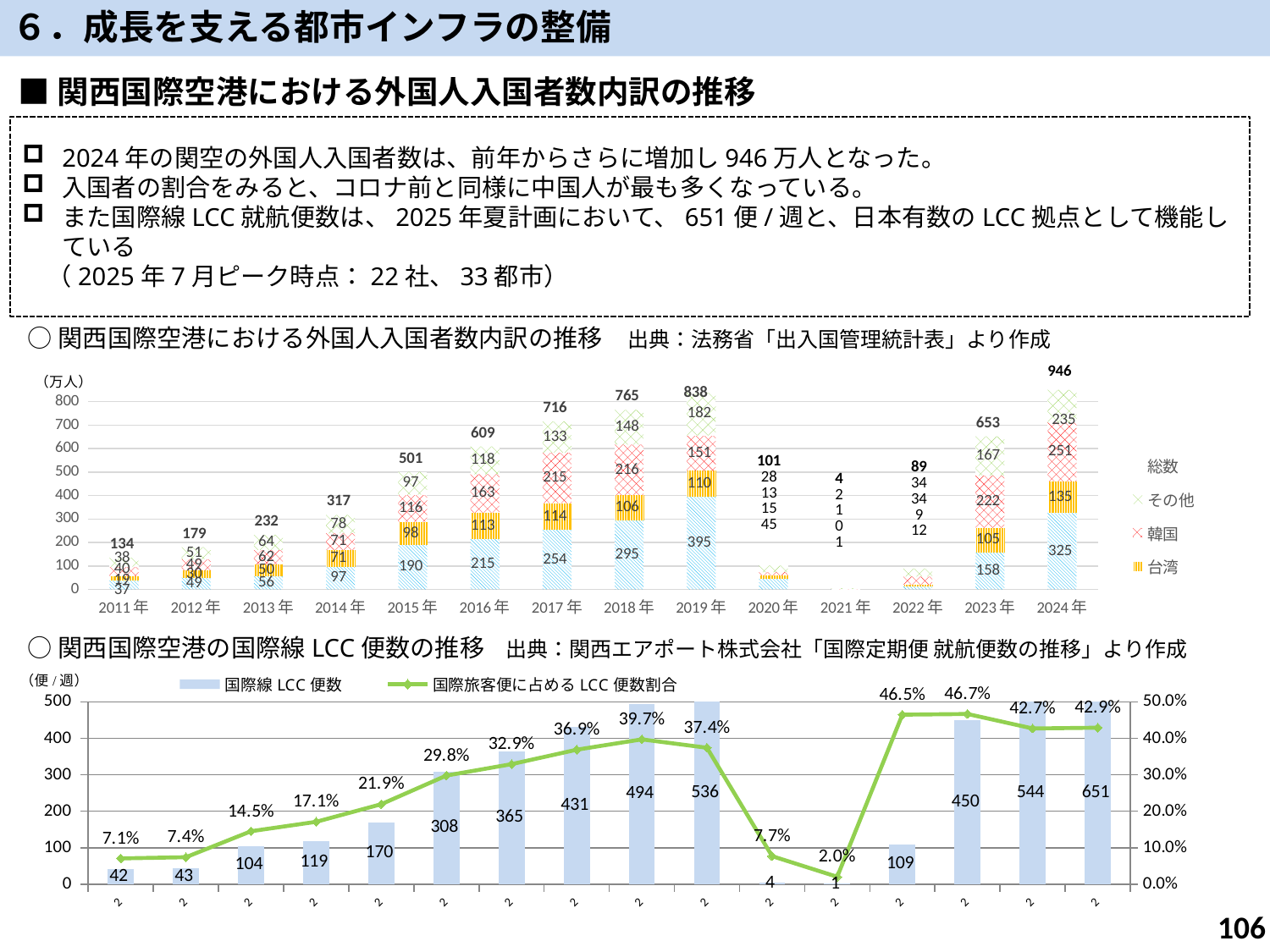
In the top chart, how many years are shown on the x axis? 14 In the top chart, which year has the highest total number of foreign entrants? 2024年 In the top chart, what is the difference between the totals for 2024年 and 2023年? 293 In the top chart (関西国際空港における外国人入国者数内訳の推移), what is the total (総数) for 2024年? 946 In the top chart, what is the 韓国 value for 2024年? 251 In the top chart, what is the 台湾 value for 2019年? 110 In the bottom chart, what is the highest value of 国際旅客便に占めるLCC便数割合 shown? 46.7% In the bottom chart (関西国際空港の国際線LCC便数の推移), how many series does the legend list? 2 In the top chart, what is the total for 2022年? 89 In the top chart, which year has the larger total, 2018年 or 2019年? 2019年 In the bottom chart, what is the highest value of 国際線LCC便数 shown? 651 In the top chart, which year has the lowest total number of foreign entrants? 2021年